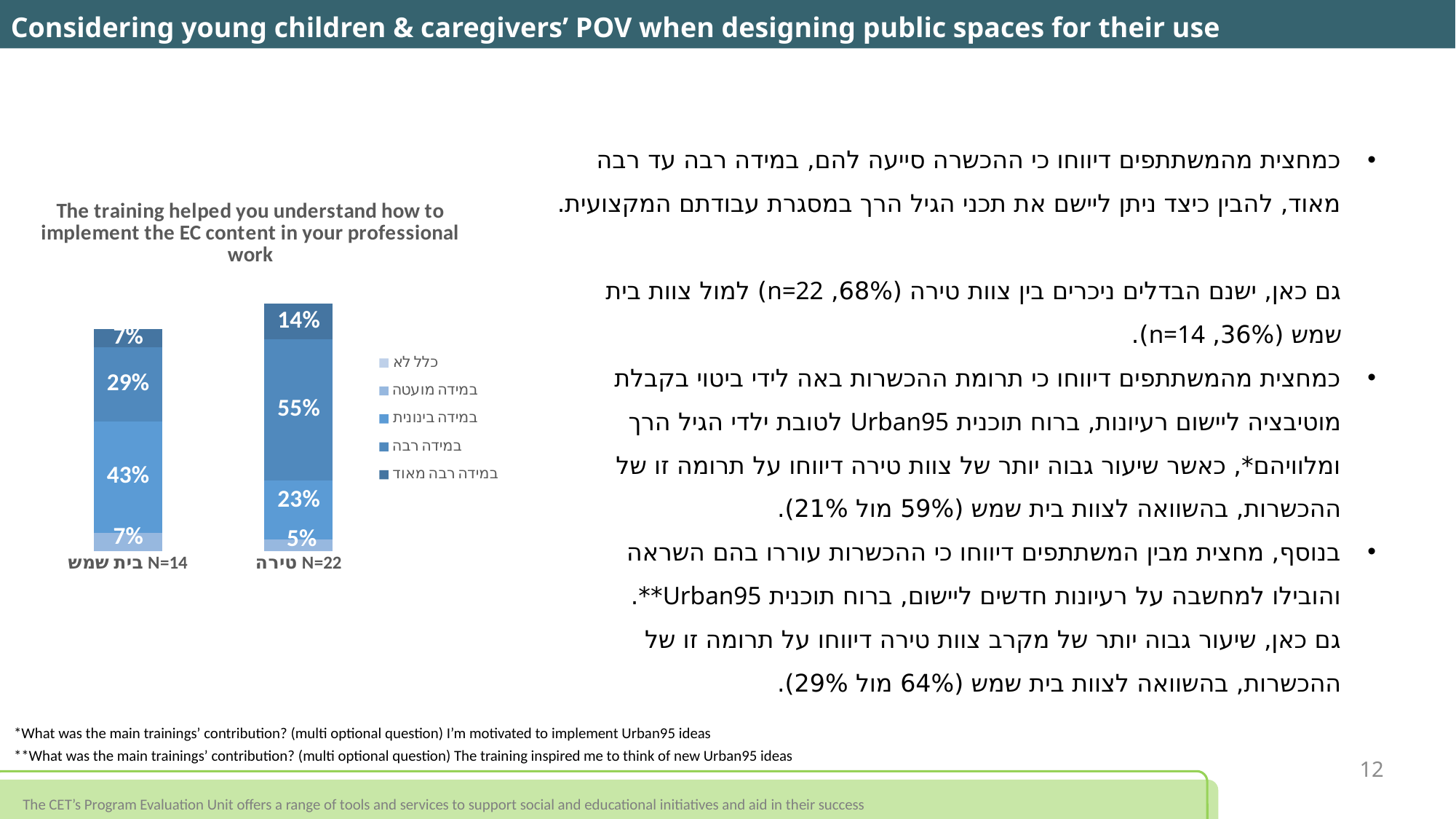
What sample size (N) is shown for the טירה bar? N=22 What is the largest segment value in the טירה bar? 55% What is the title of the chart? The training helped you understand how to implement the EC content in your professional work What is the value of the במידה רבה segment for בית שמש? 29% What is the value of the במידה בינונית segment for בית שמש? 43% How many categories (bars) does the chart show? 2 Which group has the larger במידה בינונית value, בית שמש or טירה? בית שמש What is the difference between the במידה רבה values for טירה and בית שמש? 26 percentage points What is the value of the במידה רבה מאוד segment for טירה? 14% What is the value of the במידה רבה segment for טירה? 55% What type of chart is shown on the slide? Stacked bar chart How many series does the chart's legend list? 5